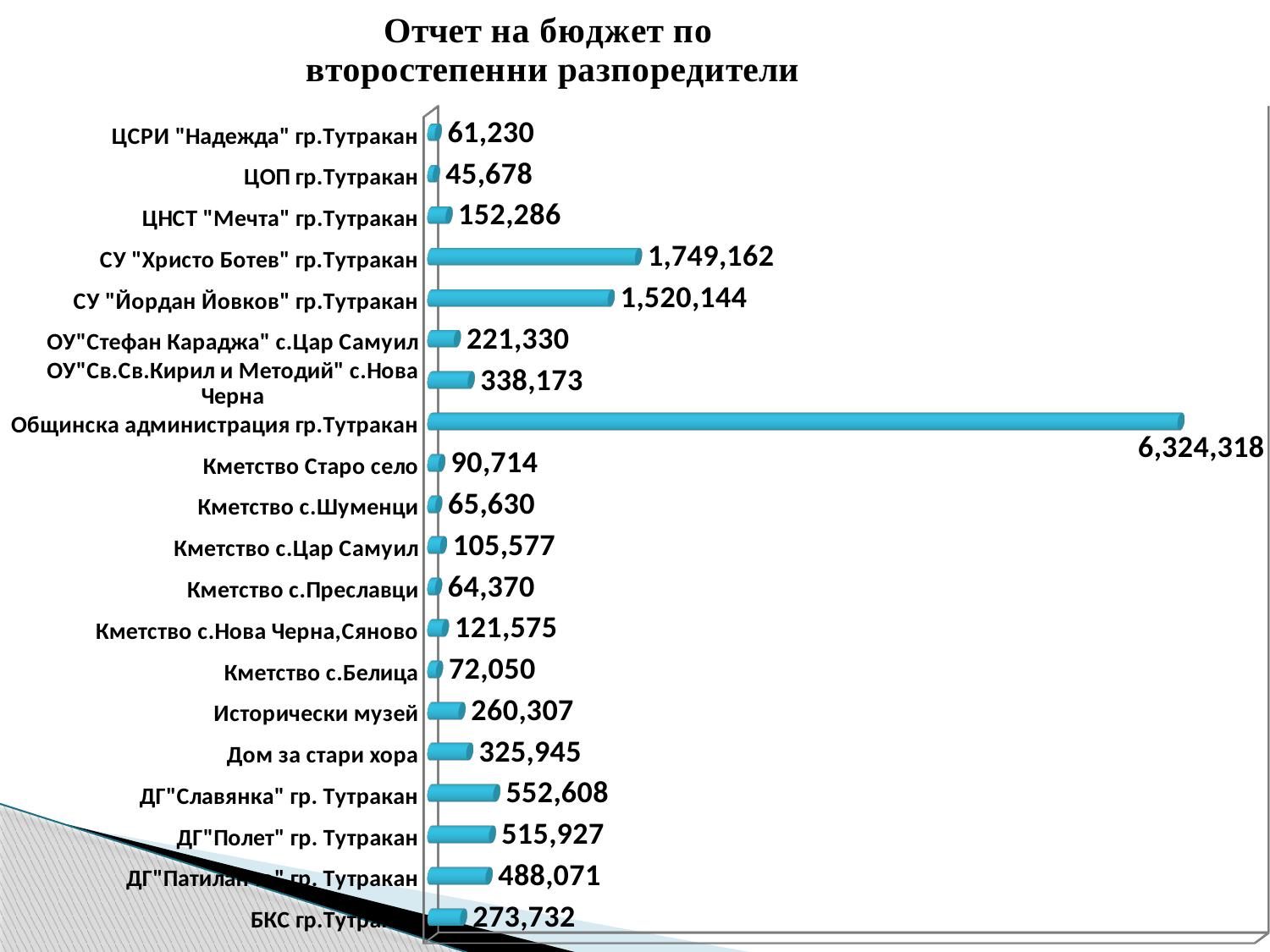
Which is larger, the value for Исторически музей or the value for Дом за стари хора? Дом за стари хора Which category has the highest value? Общинска администрация гр.Тутракан What kind of chart is shown on the slide? Bar chart What is the value for ДГ"Славянка" гр. Тутракан? 552,608 What is the value for СУ "Христо Ботев" гр.Тутракан? 1,749,162 What is the value for Кметство с.Цар Самуил? 105,577 Which category has the lowest value? ЦОП гр.Тутракан What is the difference between the values for ДГ"Славянка" гр. Тутракан and ДГ"Полет" гр. Тутракан? 36,681 How many categories are shown in the chart? 20 What is the title of the chart? Отчет на бюджет по второстепенни разпоредители What is the value for Дом за стари хора? 325,945 What is the difference between the values for СУ "Христо Ботев" гр.Тутракан and СУ "Йордан Йовков" гр.Тутракан? 229,018